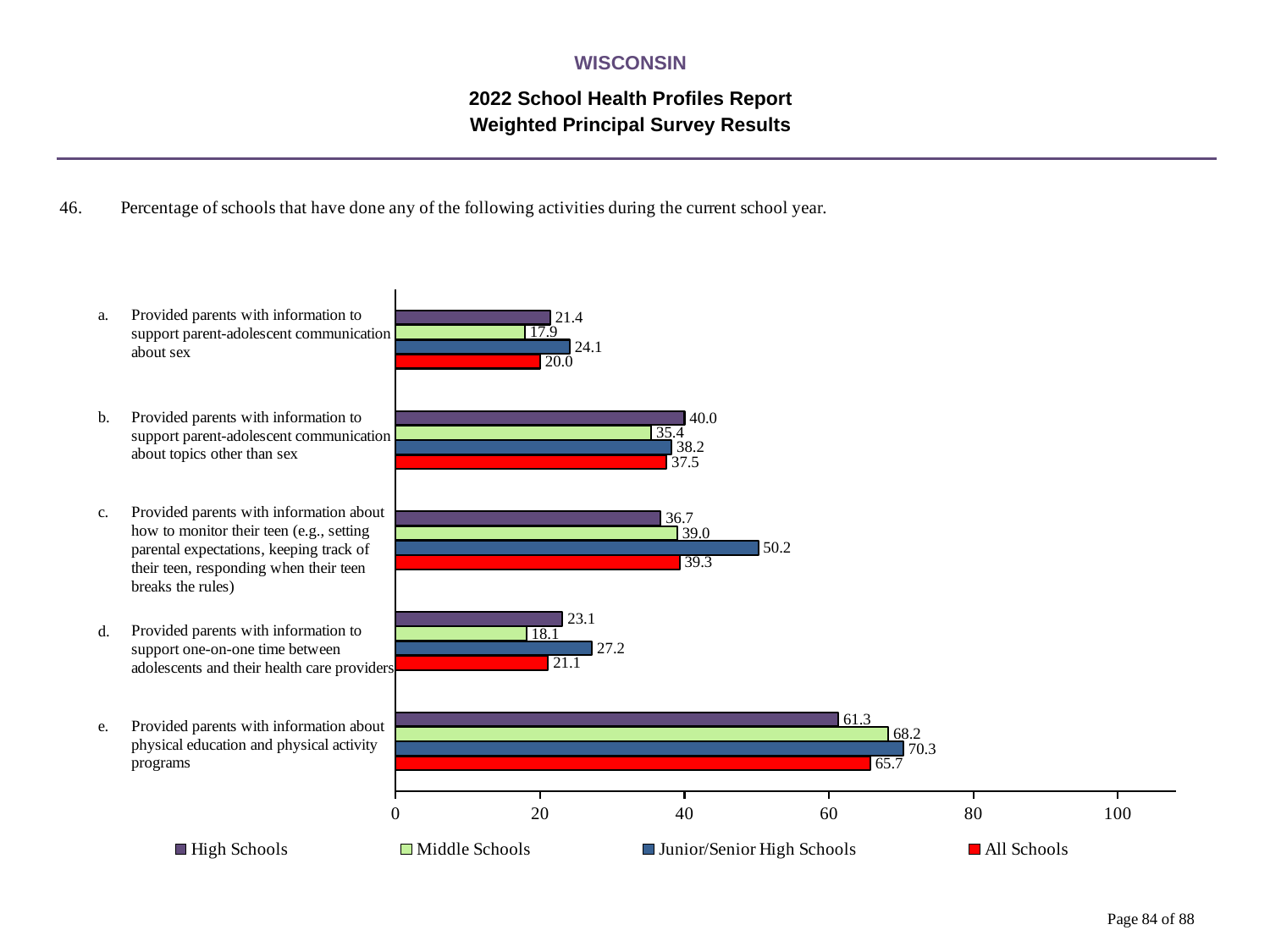
What is the value for High Schools for activity e (information about physical education and physical activity programs)? 61.3 Which activity has the highest All Schools value? e. Provided parents with information about physical education and physical activity programs What kind of chart is shown on the slide? Bar chart What is the All Schools value for activity a (information to support parent-adolescent communication about sex)? 20.0 Which series is shown in red in the legend? All Schools What is the Middle Schools value for activity d (information to support one-on-one time between adolescents and their health care providers)? 18.1 Which activity has the lowest Middle Schools value? a. Provided parents with information to support parent-adolescent communication about sex How many series does the legend list? 4 For activity b, which is larger: the High Schools value or the Middle Schools value? High Schools How many activities (categories) are shown in the chart? 5 What is the difference between the Junior/Senior High Schools and High Schools values for activity c? 13.5 What is the value for Junior/Senior High Schools for activity c (information about how to monitor their teen)? 50.2